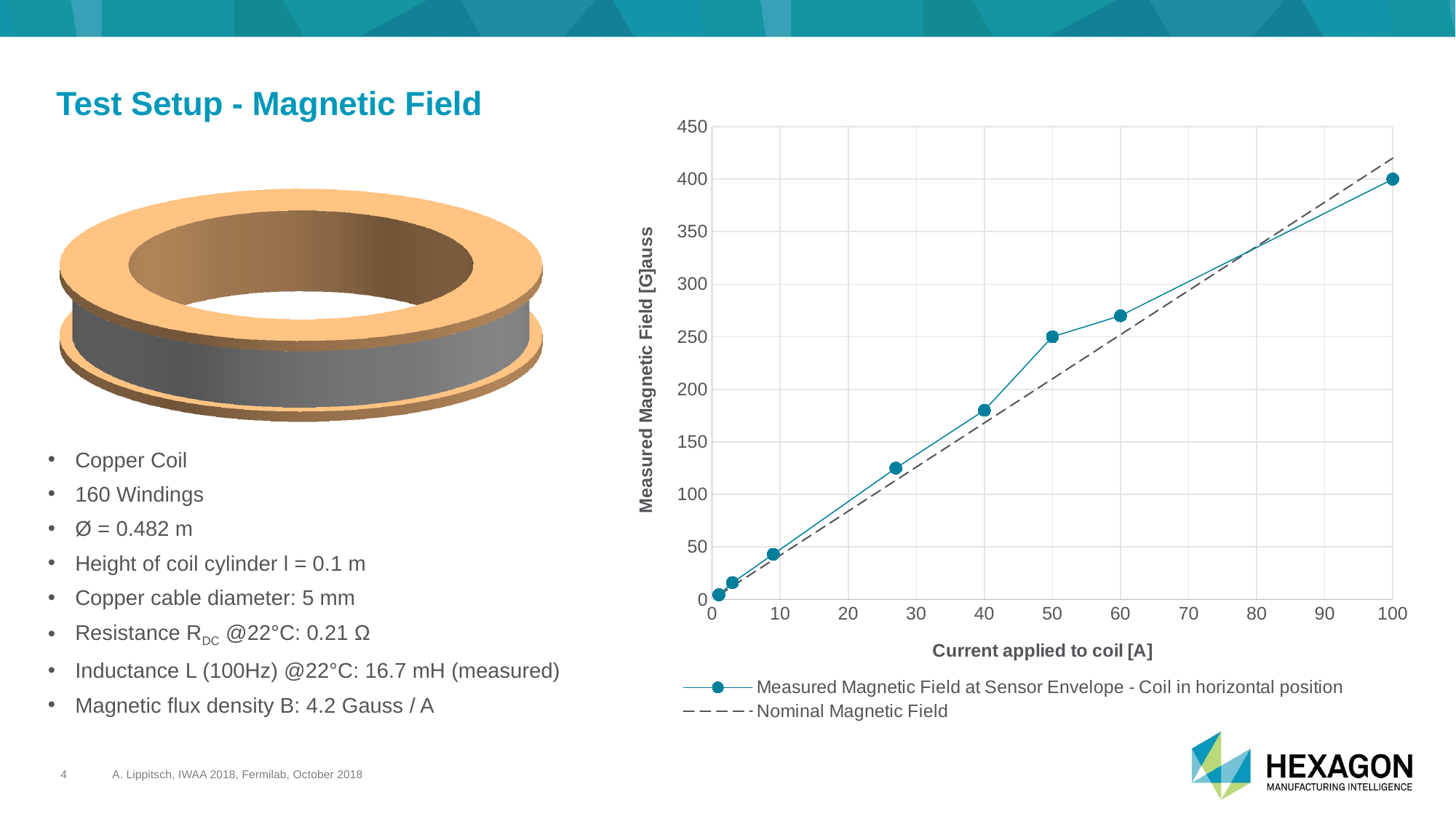
Is the measured magnetic field at 9 A greater or less than 50? less Does the measured magnetic field rise or fall as the current applied to the coil increases? rise How many measured data points are plotted on the chart? 8 Is the measured magnetic field at 40 A greater or less than 200? less Which series is drawn with a dashed line in the chart? Nominal Magnetic Field Is the measured magnetic field at 27 A greater or less than 100? greater At 100 A, which is larger: the nominal magnetic field or the measured magnetic field? nominal magnetic field What kind of chart is shown on the slide? line chart What is the title of the x axis of the chart? Current applied to coil [A] At 50 A, which is larger: the measured magnetic field or the nominal magnetic field? measured magnetic field How many series does the chart legend list? 2